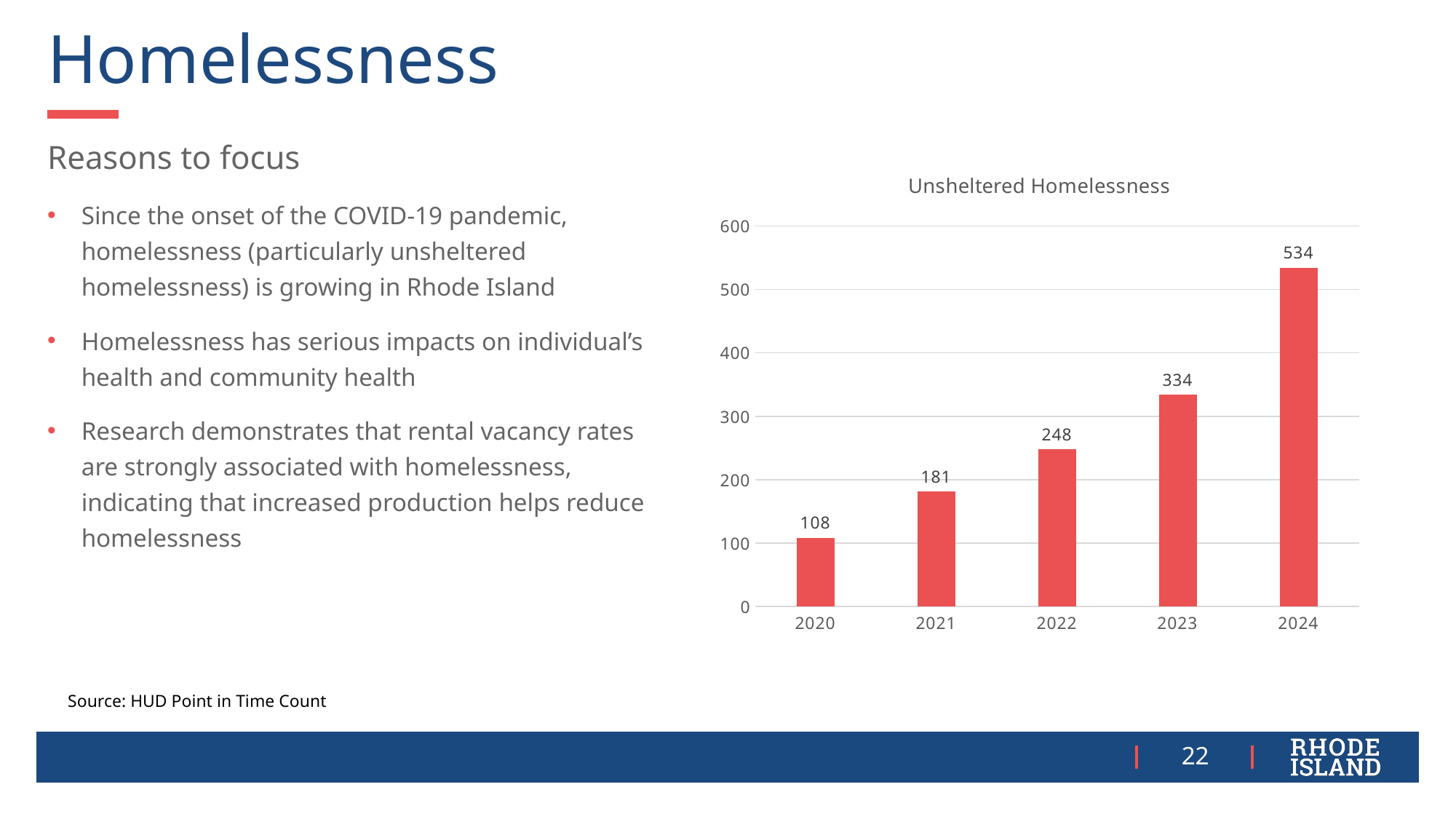
Which year has the lowest value in the Unsheltered Homelessness chart? 2020 What is the difference between the 2024 and 2023 values in the Unsheltered Homelessness chart? 200 How many years are shown in the Unsheltered Homelessness chart? 5 What kind of chart is the Unsheltered Homelessness chart? bar chart Which is larger in the Unsheltered Homelessness chart, the value for 2022 or the value for 2023? 2023 What is the value for 2024 in the Unsheltered Homelessness chart? 534 What is the value for 2022 in the Unsheltered Homelessness chart? 248 Is the value for 2023 in the Unsheltered Homelessness chart greater or less than 300? greater What is the value for 2020 in the Unsheltered Homelessness chart? 108 Do the values in the Unsheltered Homelessness chart rise or fall from 2020 to 2024? rise What is the difference between the 2021 and 2020 values in the Unsheltered Homelessness chart? 73 Which year has the highest value in the Unsheltered Homelessness chart? 2024